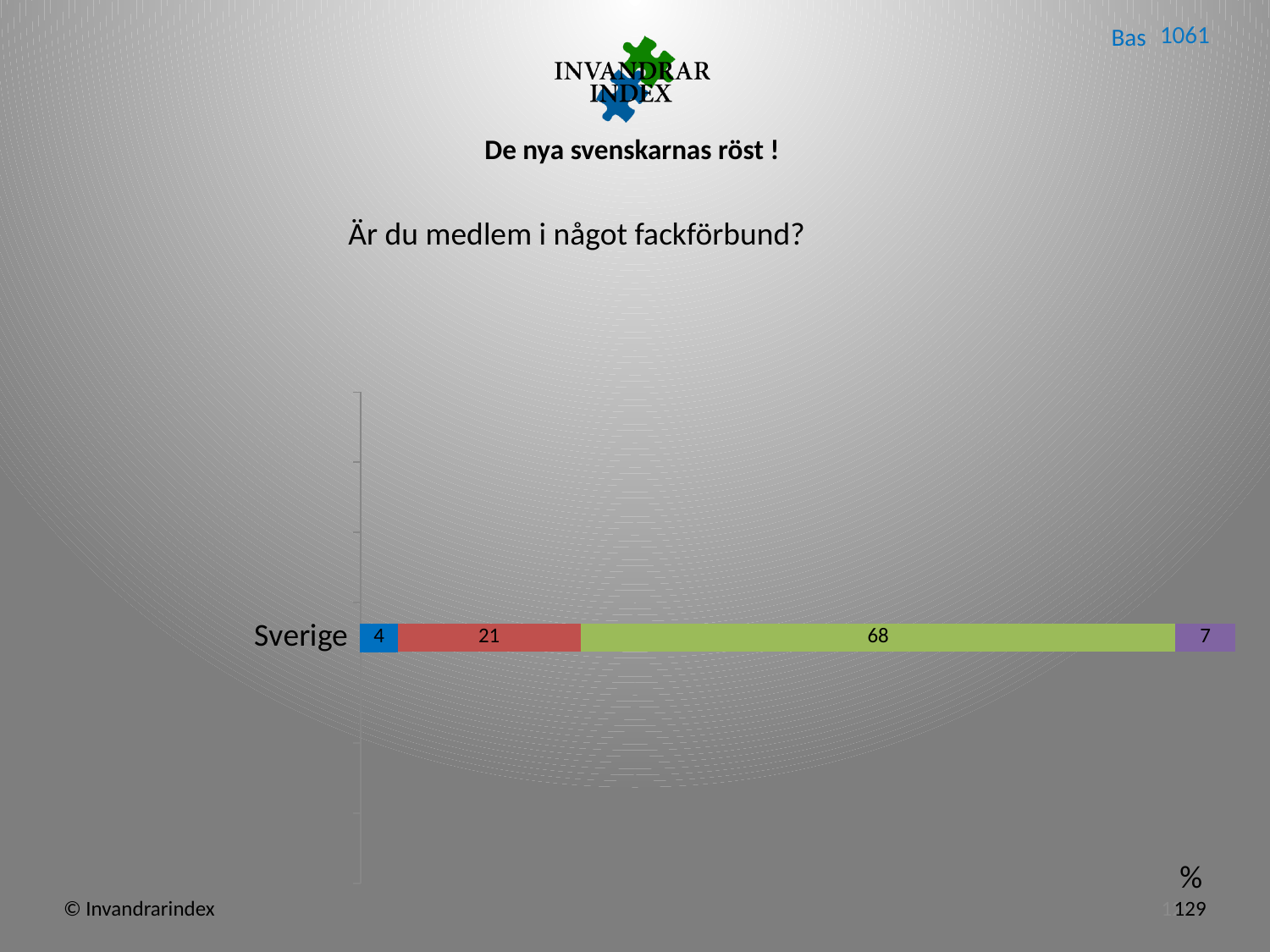
Which segment of the Sverige bar has the smallest value? the blue segment (4) Which is larger, the red segment or the purple segment of the Sverige bar? the red segment What is the value of the red segment of the Sverige bar? 21 What is the value of the purple segment of the Sverige bar? 7 What is the value of the green segment of the Sverige bar? 68 Which segment of the Sverige bar has the largest value? the green segment (68) What is the total of all segments in the Sverige bar? 100 What type of chart is shown on the slide? stacked bar chart What is the difference between the green segment and the red segment of the Sverige bar? 47 What is the value of the blue segment of the Sverige bar? 4 How many categories are plotted on the chart? 1 What is the label of the single category on the chart? Sverige